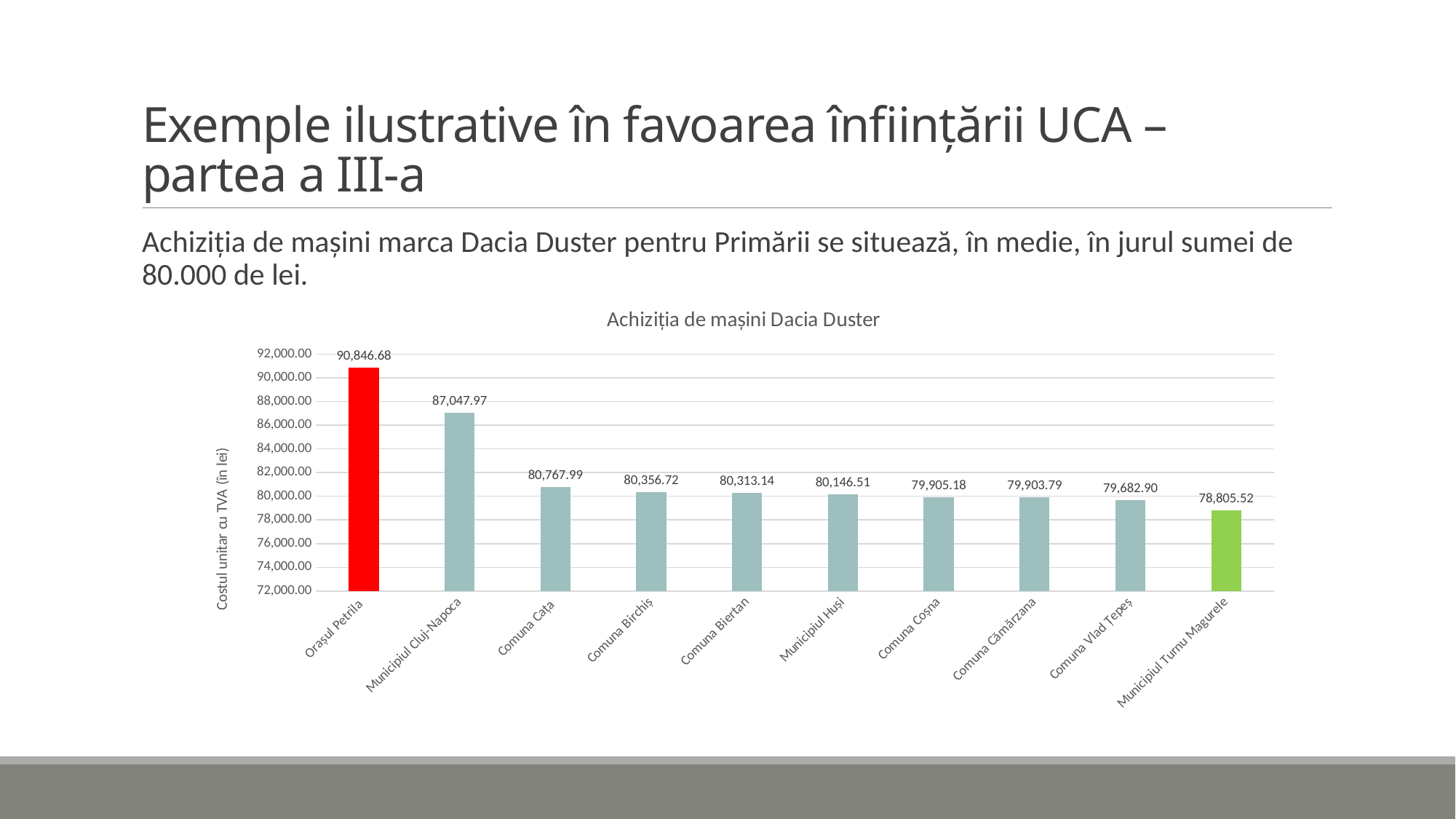
Is the value for Municipiul Turnu Magurele greater or less than 80,000.00? less What kind of chart is shown on the slide? bar chart Which category has the highest value? Orașul Petrila What is the difference between the values for Orașul Petrila and Municipiul Cluj-Napoca? 3,798.71 Which is larger, the value for Municipiul Huși or the value for Comuna Vlad Țepeș? Municipiul Huși What is the value for Municipiul Turnu Magurele? 78,805.52 Which category has the lowest value? Municipiul Turnu Magurele What is the value for Comuna Biertan? 80,313.14 What is the value for Orașul Petrila? 90,846.68 What is the value for Municipiul Cluj-Napoca? 87,047.97 How many categories are shown on the x axis? 10 Do the values rise or fall from left to right along the x axis? fall